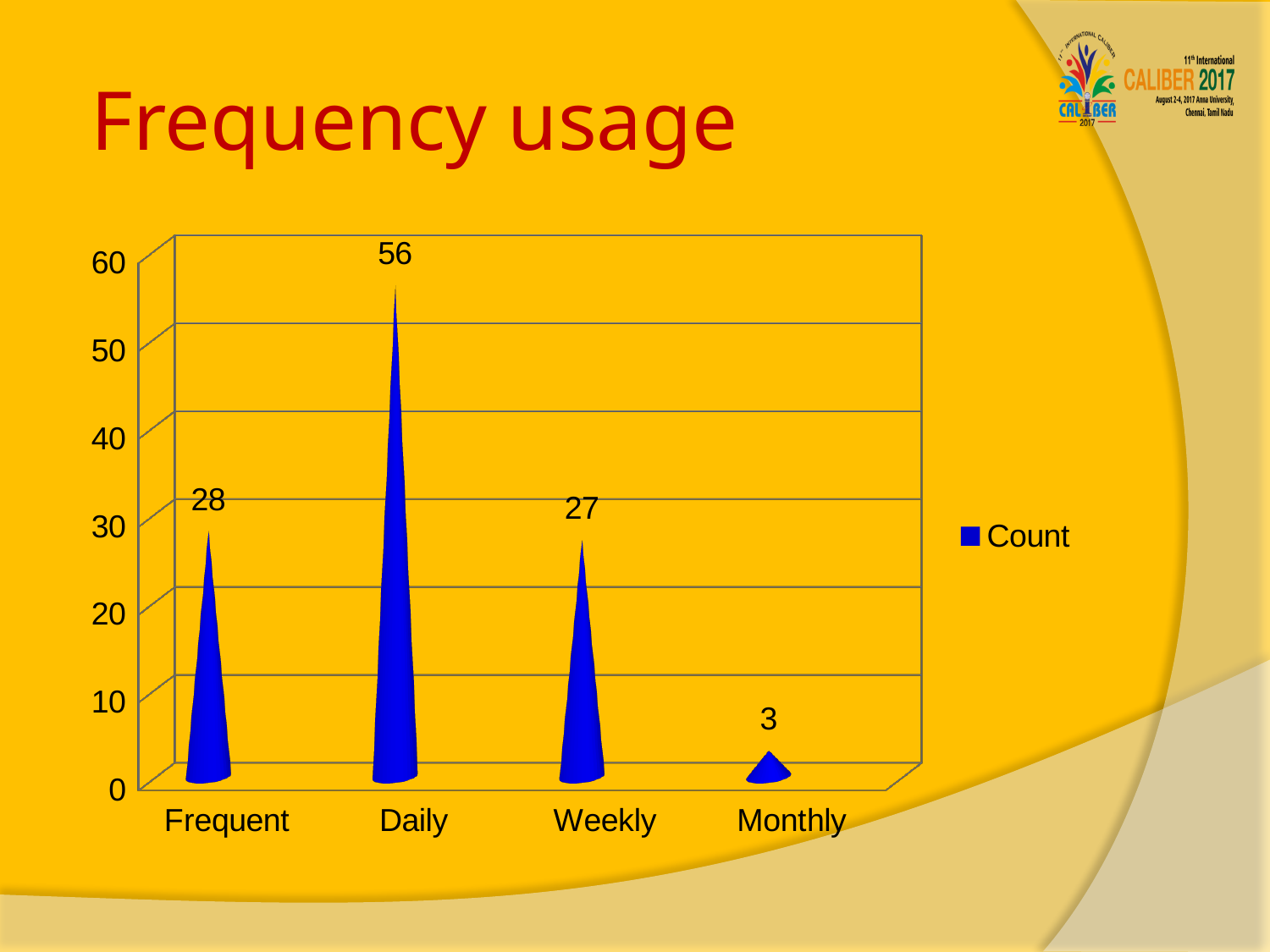
What is the Count value for Frequent? 28 Is the value for Weekly greater or less than 30? less What is the Count value for Monthly? 3 Which category has the highest Count? Daily How many categories are shown on the x axis? 4 How many series does the legend list? 1 What is the title of the slide containing the chart? Frequency usage What is the Count value for Daily? 56 What kind of chart is shown on the slide? bar chart Which category has the lowest Count? Monthly What is the difference between the Count for Daily and the Count for Weekly? 29 Which has a larger Count, Frequent or Monthly? Frequent